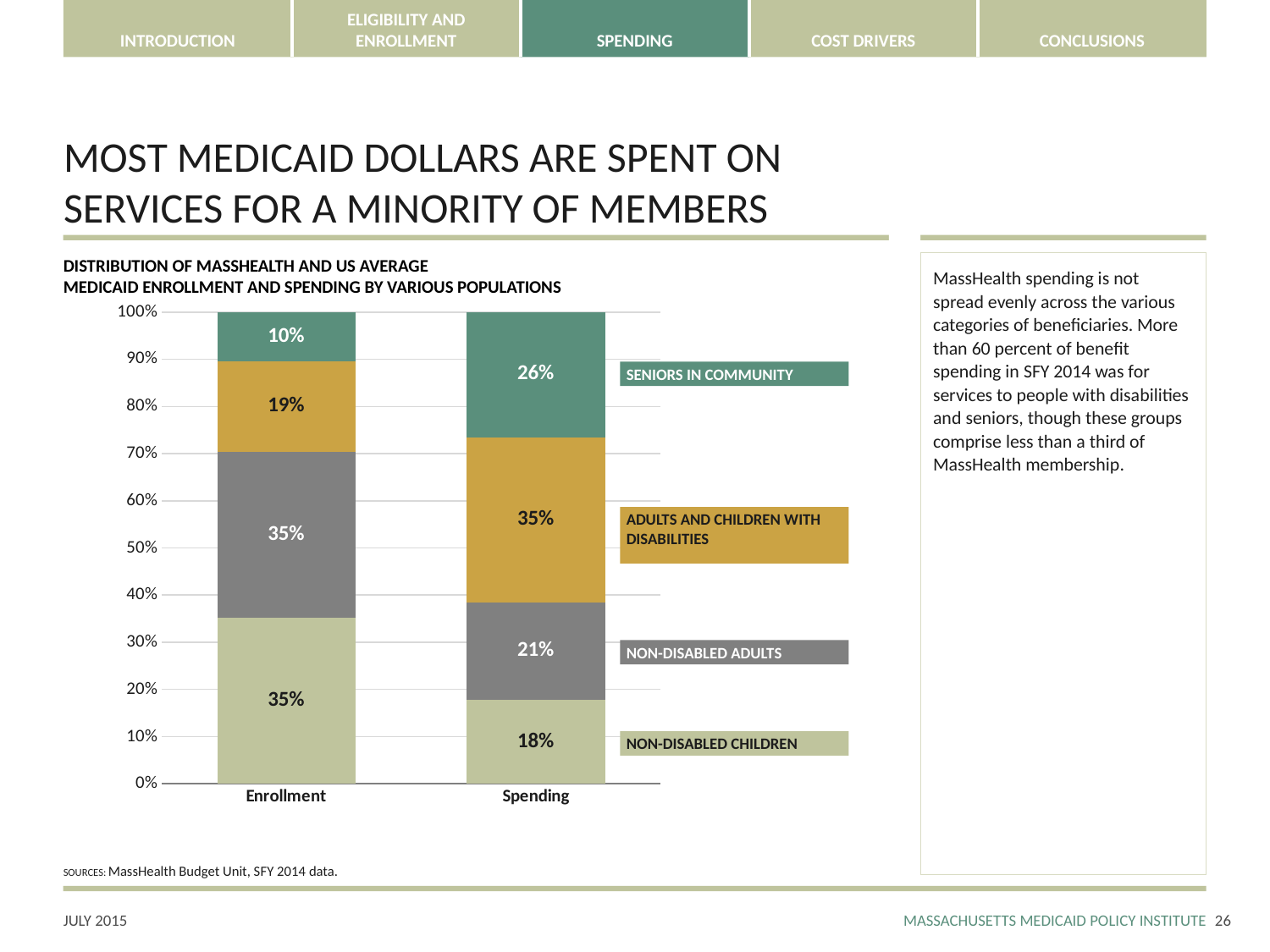
What type of chart is shown? stacked bar chart What share of Enrollment is Adults and Children with Disabilities? 19% Which population has the largest share of Spending? Adults and Children with Disabilities What share of Spending is Seniors in Community? 26% What share of Spending is Non-Disabled Adults? 21% How many bars are shown on the chart? 2 What share of Spending is Non-Disabled Children? 18% Is the Enrollment share for Non-Disabled Children larger or smaller than its Spending share? larger How many population groups does the legend list? 4 What is the difference between the Spending share and the Enrollment share for Seniors in Community? 16% Which population has the smallest share of Enrollment? Seniors in Community What share of Enrollment is Seniors in Community? 10%